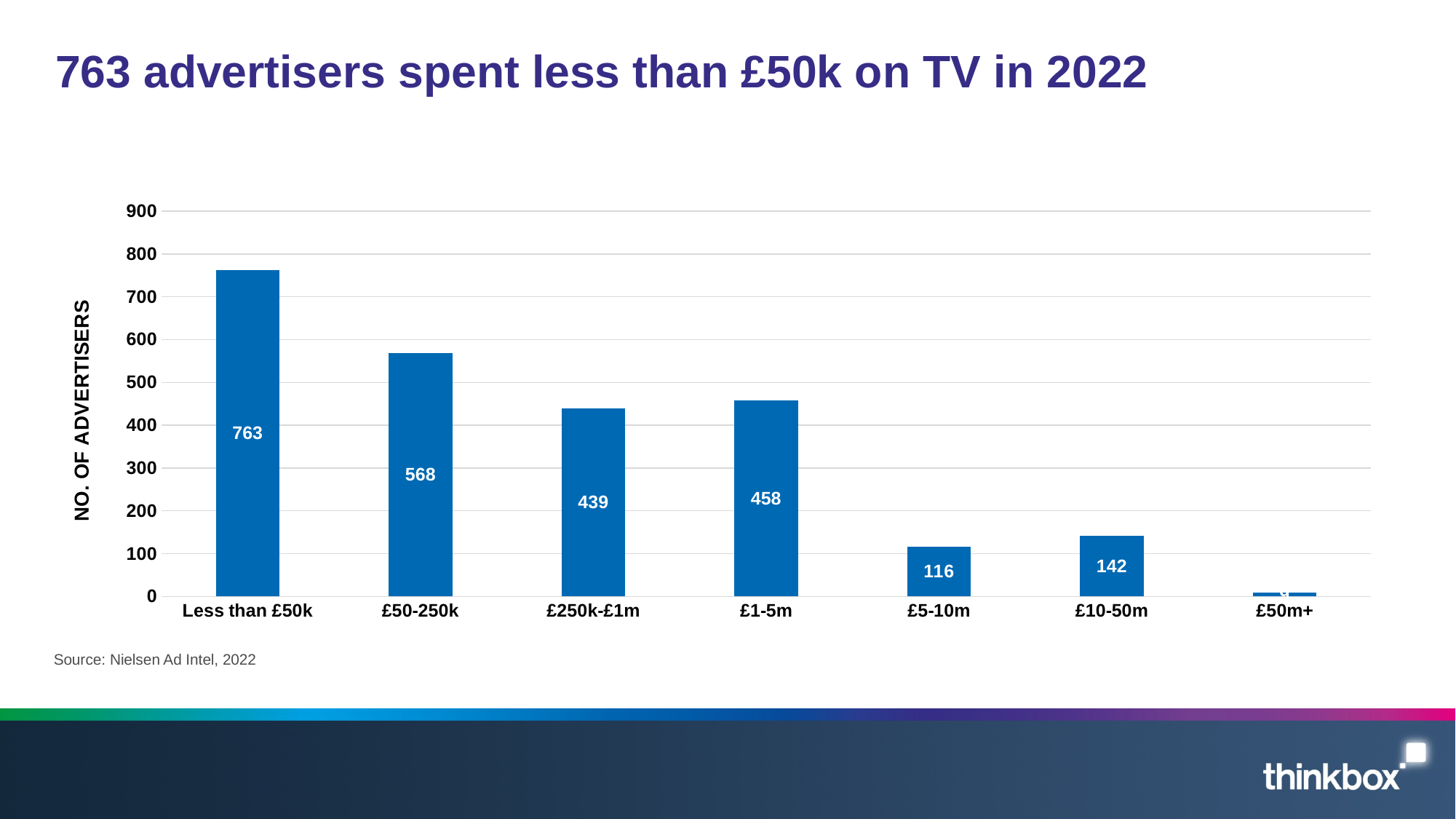
How many spend bands are shown on the x axis? 7 Is the number of advertisers in the £50m+ band greater or less than 100? less What is the number of advertisers in the £1-5m band? 458 Which spend band has the lowest number of advertisers? £50m+ Which band has more advertisers, £250k-£1m or £1-5m? £1-5m What is the number of advertisers in the £10-50m band? 142 What is the difference in the number of advertisers between the Less than £50k band and the £50-250k band? 195 How many advertisers spent less than £50k on TV in 2022? 763 What type of chart is shown on the slide? Bar chart Which spend band has the highest number of advertisers? Less than £50k What is the difference in the number of advertisers between the £10-50m band and the £5-10m band? 26 What is the number of advertisers in the £50-250k band? 568